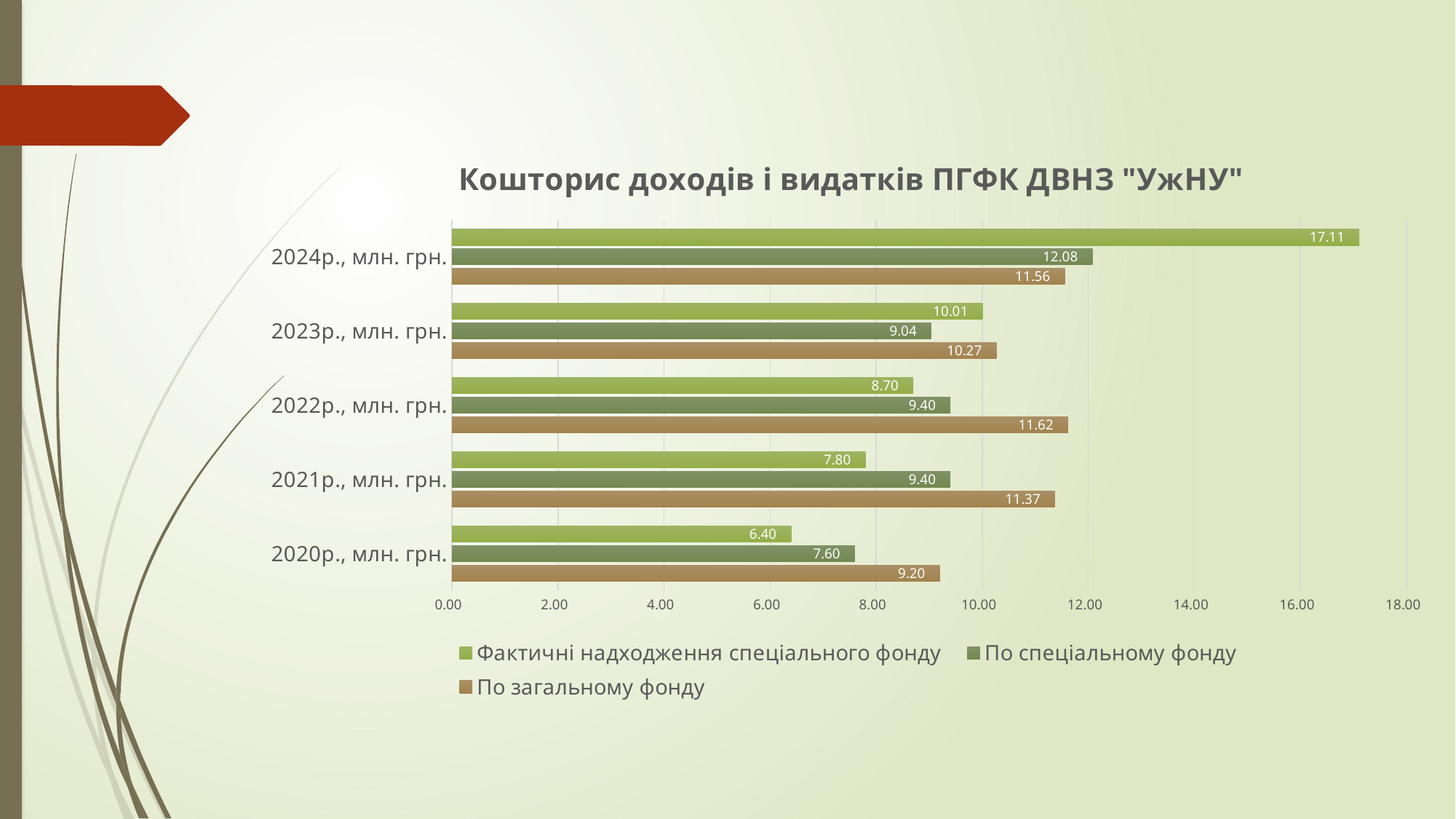
How many series does the legend list? 3 For 2022р., млн. грн., which is larger: "По спеціальному фонду" or "По загальному фонду"? По загальному фонду What is the value of "Фактичні надходження спеціального фонду" for 2024р., млн. грн.? 17.11 Is the value of "По загальному фонду" for 2021р., млн. грн. greater or less than 10.00? greater What type of chart is shown on the slide? Bar chart How many years (categories) are shown on the chart? 5 What is the value of "По загальному фонду" for 2020р., млн. грн.? 9.20 Which year has the highest value for "Фактичні надходження спеціального фонду"? 2024р., млн. грн. Which year has the lowest value for "По загальному фонду"? 2020р., млн. грн. What is the title of the chart? Кошторис доходів і видатків ПГФК ДВНЗ "УжНУ" What is the value of "По спеціальному фонду" for 2023р., млн. грн.? 9.04 What is the difference between "Фактичні надходження спеціального фонду" and "По спеціальному фонду" for 2024р., млн. грн.? 5.03